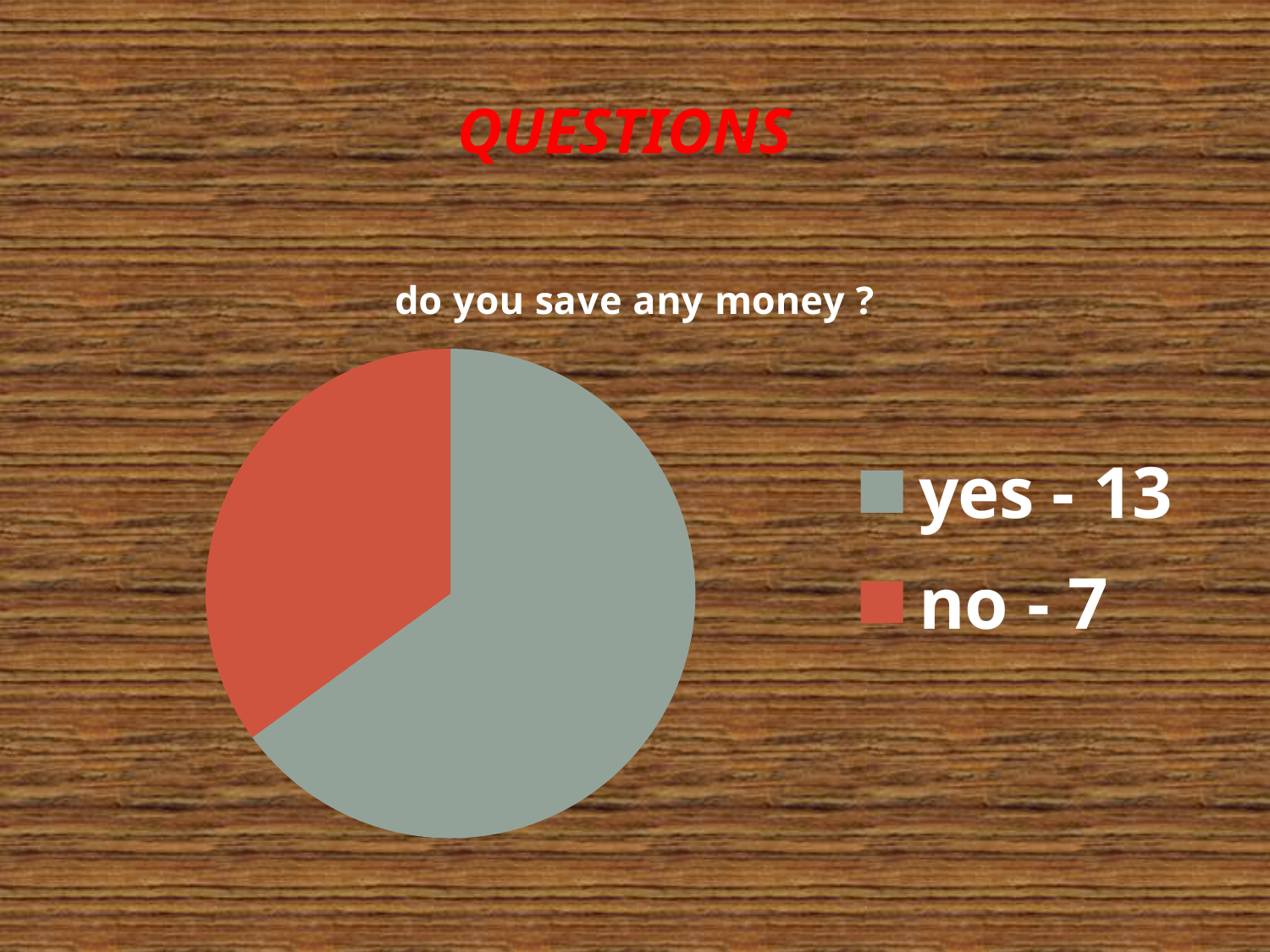
What is the value for "no"? 7 How many entries does the legend list? 2 What is the total of all slices in the pie chart? 20 Which is larger, the value for "yes" or the value for "no"? yes What share of the pie does the "yes" slice represent? 65% What is the title of the chart? do you save any money ? Which category has the smallest slice? no Which category has the largest slice? yes How many slices does the pie chart have? 2 What is the value for "yes"? 13 What is the difference between the "yes" and "no" values? 6 What kind of chart is shown on the slide? pie chart